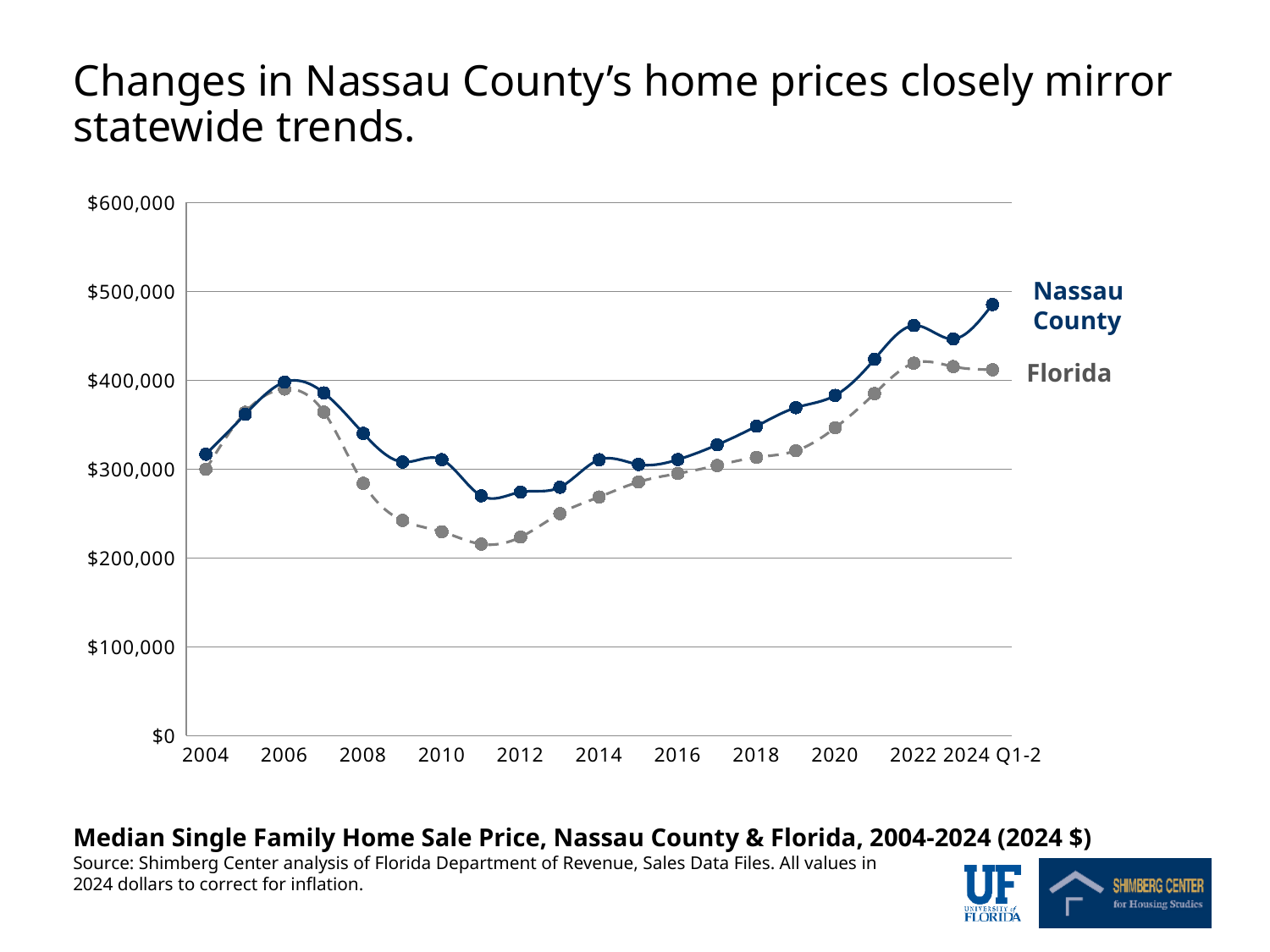
What kind of chart is shown on the slide? line chart In which year does the Nassau County series reach its highest value? 2024 Q1-2 Is the Nassau County value for 2011 greater or less than $300,000? less Is the Florida value for 2011 greater or less than $200,000? greater In 2024 Q1-2, which series has the higher value, Nassau County or Florida? Nassau County Do Nassau County home prices rise or fall between 2012 and 2022? rise Is the Florida value for 2022 greater or less than $400,000? greater What are the two series plotted on the chart? Nassau County and Florida What is the title of the chart? Median Single Family Home Sale Price, Nassau County & Florida, 2004-2024 (2024 $) How many series does the chart show? 2